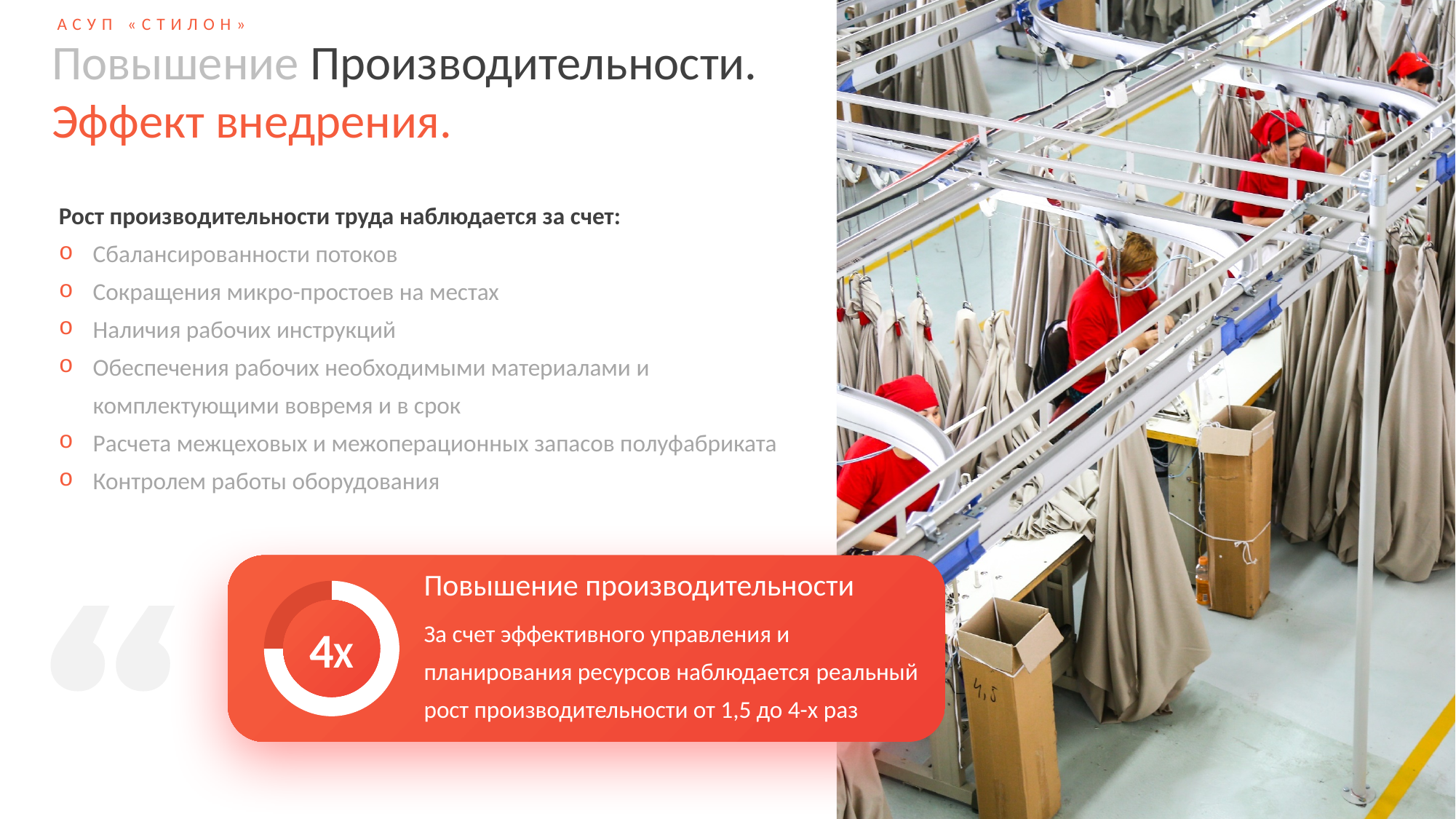
What colour is the filled portion of the ring chart in the orange box? white What value is printed in the centre of the ring chart in the orange box? 4x What kind of chart is shown in the orange box at the bottom of the slide? doughnut chart What heading appears next to the ring chart in the orange box? Повышение производительности